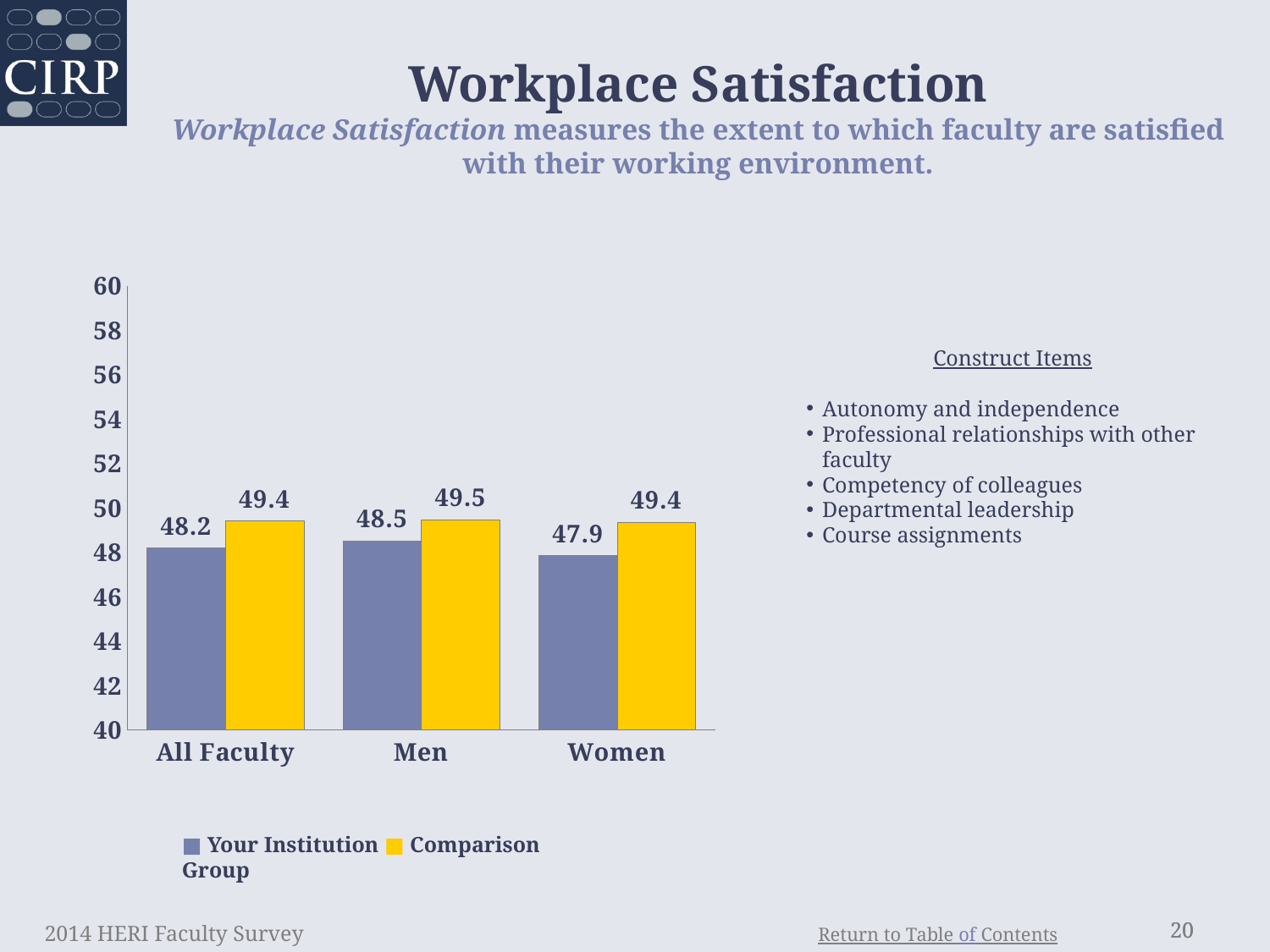
What is the difference between the Comparison Group and Your Institution values for Women? 1.5 Which category has the highest Your Institution value? Men What is the difference between the Your Institution values for Men and Women? 0.6 Which category has the lowest Your Institution value? Women What is the Your Institution value for Women? 47.9 What is the Your Institution value for All Faculty? 48.2 How many categories are shown on the x axis? 3 How many series does the legend list? 2 What is the Comparison Group value for Men? 49.5 What kind of chart is shown on the slide? Bar chart What is the Comparison Group value for Women? 49.4 For Men, which is larger: Your Institution or Comparison Group? Comparison Group